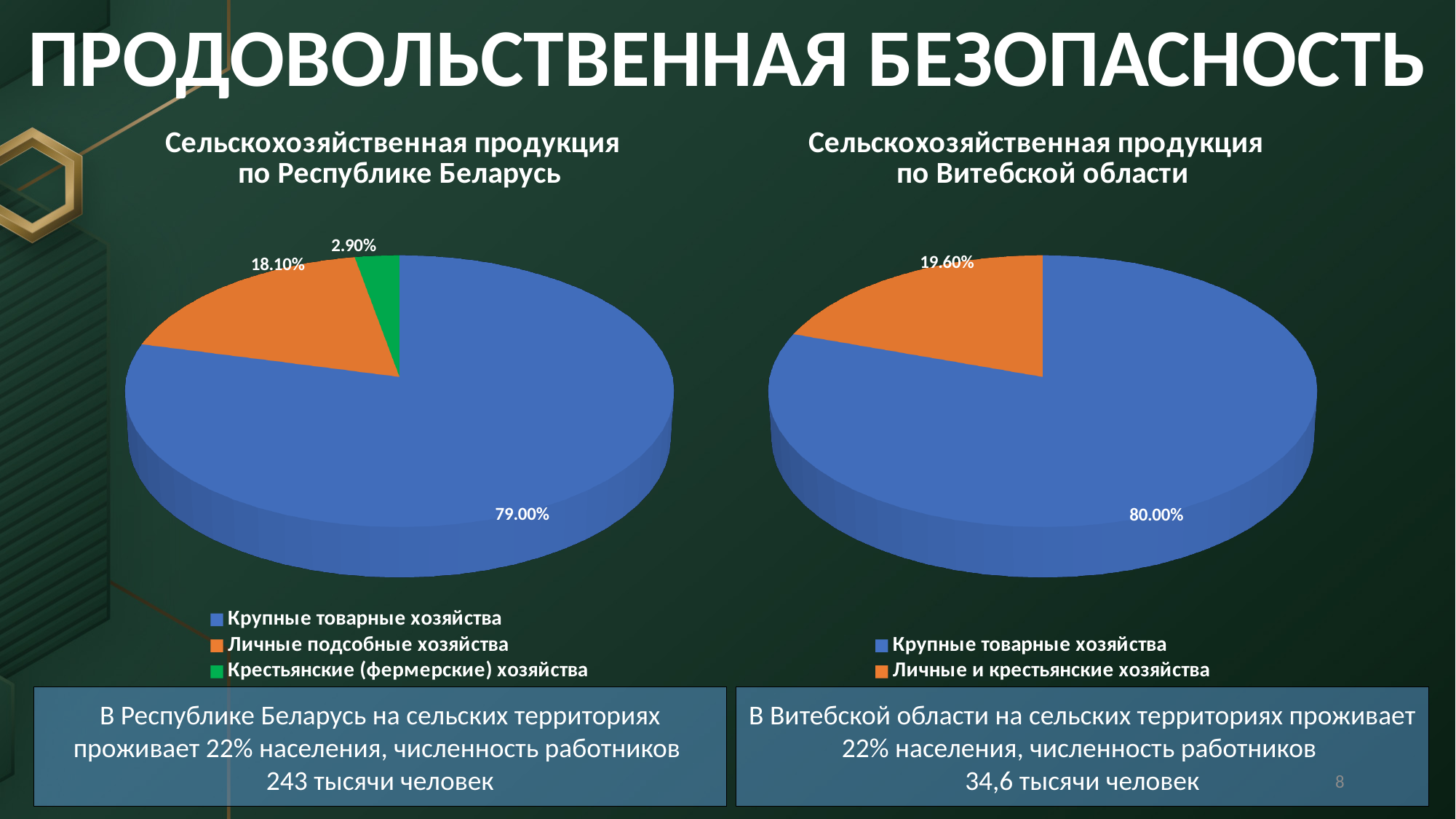
In the chart 'Сельскохозяйственная продукция по Витебской области', which category has the largest slice? Крупные товарные хозяйства How many categories does the legend of the chart 'Сельскохозяйственная продукция по Республике Беларусь' list? 3 In the chart 'Сельскохозяйственная продукция по Республике Беларусь', which category has the smallest slice? Крестьянские (фермерские) хозяйства In the chart 'Сельскохозяйственная продукция по Витебской области', what share is labelled for Личные и крестьянские хозяйства? 19.60% In the chart 'Сельскохозяйственная продукция по Республике Беларусь', what share is labelled for Личные подсобные хозяйства? 18.10% In the chart 'Сельскохозяйственная продукция по Республике Беларусь', what share is labelled for Крестьянские (фермерские) хозяйства? 2.90% How many categories does the legend of the chart 'Сельскохозяйственная продукция по Витебской области' list? 2 Which is larger: the share of Крупные товарные хозяйства in the chart for Республика Беларусь or in the chart for Витебская область? Витебская область In the chart 'Сельскохозяйственная продукция по Республике Беларусь', what is the difference between the shares of Личные подсобные хозяйства and Крестьянские (фермерские) хозяйства? 15.20% In the chart 'Сельскохозяйственная продукция по Республике Беларусь', what share is labelled for Крупные товарные хозяйства? 79.00% In the chart 'Сельскохозяйственная продукция по Витебской области', what share is labelled for Крупные товарные хозяйства? 80.00% What type of chart is 'Сельскохозяйственная продукция по Витебской области'? Pie chart